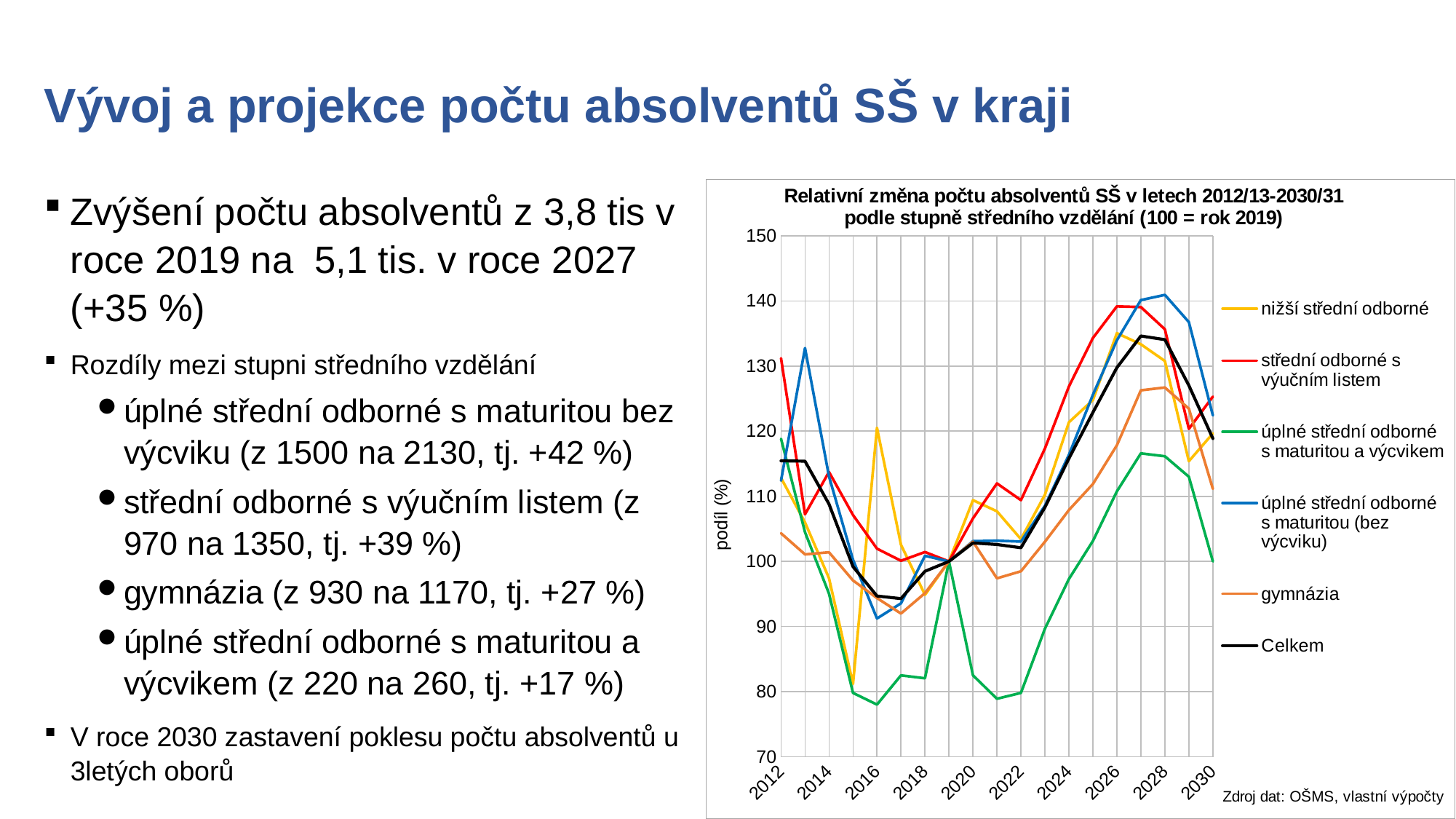
Is the value for úplné střední odborné s maturitou a výcvikem in 2024 greater or less than 100? less Which series has the lowest value in 2016? úplné střední odborné s maturitou a výcvikem Is the value for gymnázia in 2027 greater or less than 120? greater What is the label of the vertical axis of the chart? podíl (%) Does the Celkem series rise or fall between 2022 and 2027? rise Is the value for Celkem in 2016 greater or less than 100? less What is the value of the Celkem series in 2019? 100 In 2024, which is larger: the value for střední odborné s výučním listem or the value for gymnázia? střední odborné s výučním listem How many series does the chart legend list? 6 Which series has the highest value in 2013? úplné střední odborné s maturitou (bez výcviku) What kind of chart is shown on the slide? line chart